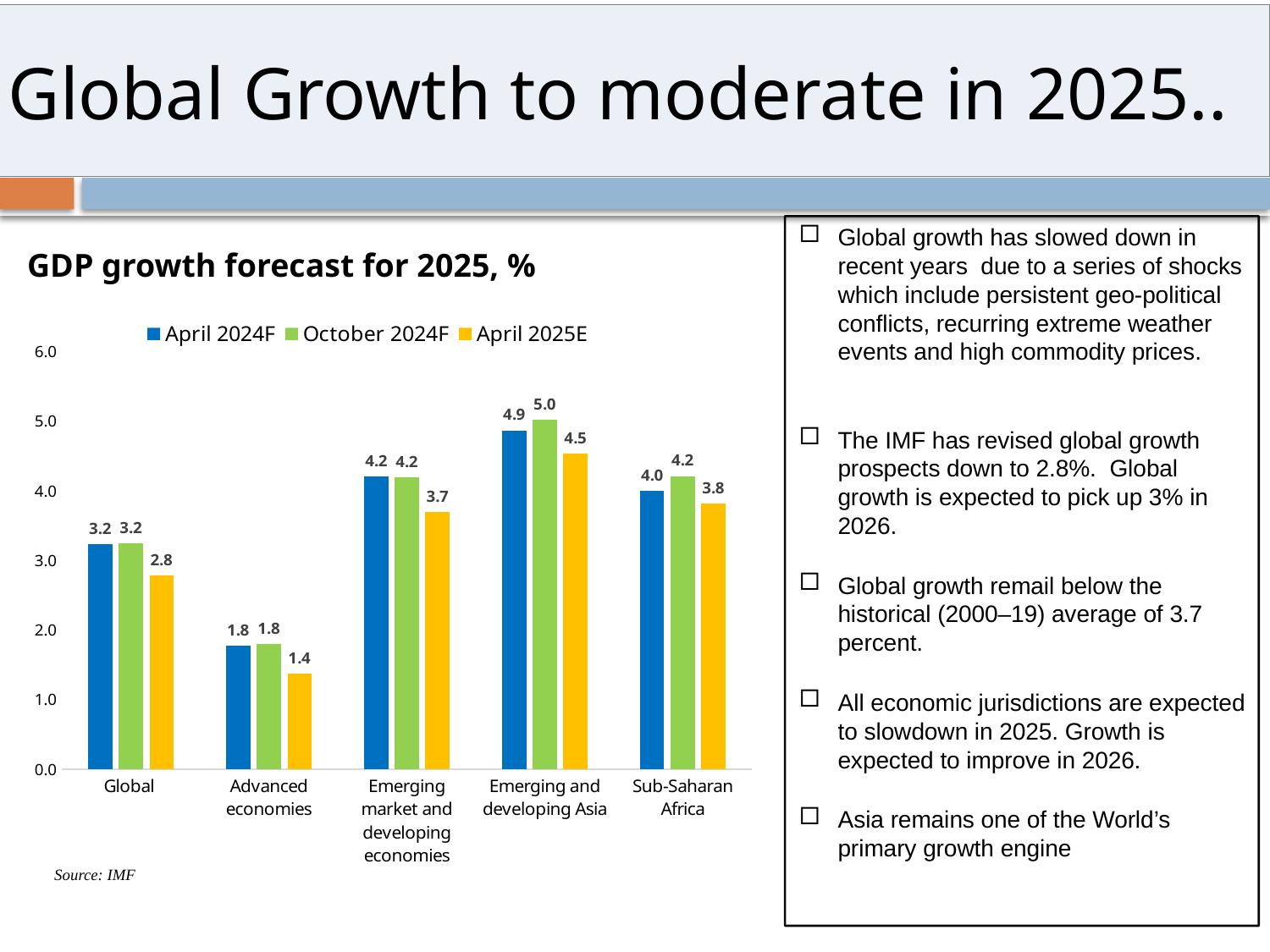
Which is larger for Sub-Saharan Africa: the April 2024F value or the October 2024F value? October 2024F What is the April 2025E value for Advanced economies? 1.4 How many series does the legend list? 3 What is the title of the chart? GDP growth forecast for 2025, % What is the April 2025E GDP growth forecast for Global? 2.8 Is the April 2025E value for Emerging and developing Asia greater or less than 4.0? greater What kind of chart is shown on the slide? bar chart Which category has the lowest April 2024F value? Advanced economies How many categories are shown on the x axis? 5 What is the October 2024F value for Sub-Saharan Africa? 4.2 What is the difference between the October 2024F and April 2025E values for Emerging market and developing economies? 0.5 Which category has the highest April 2025E value? Emerging and developing Asia